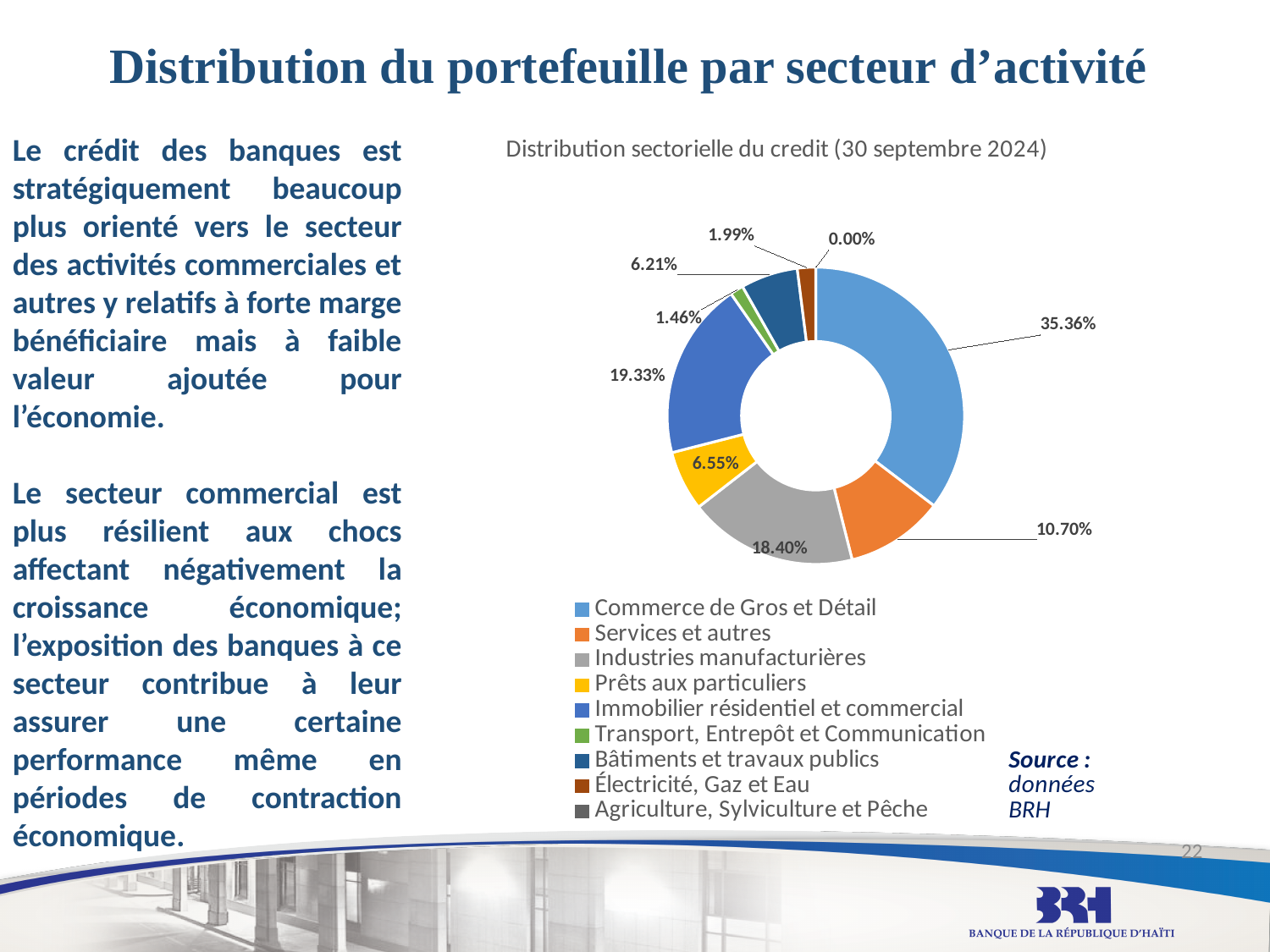
Which sector has the largest share of the credit portfolio? Commerce de Gros et Détail What kind of chart is shown on the slide? Doughnut (pie) chart What is the difference in percentage points between Commerce de Gros et Détail and Services et autres? 24.66 percentage points How many sectors does the legend list? 9 Which sector has the smallest share of the credit portfolio? Agriculture, Sylviculture et Pêche What share of the credit portfolio goes to Commerce de Gros et Détail? 35.36% What share of the credit portfolio goes to Immobilier résidentiel et commercial? 19.33% What is the title of the chart? Distribution sectorielle du credit (30 septembre 2024) What is the combined share of Transport, Entrepôt et Communication and Électricité, Gaz et Eau? 3.45% Which has a larger share: Prêts aux particuliers or Bâtiments et travaux publics? Prêts aux particuliers What share of the credit portfolio goes to Industries manufacturières? 18.40% What share of the credit portfolio goes to Agriculture, Sylviculture et Pêche? 0.00%